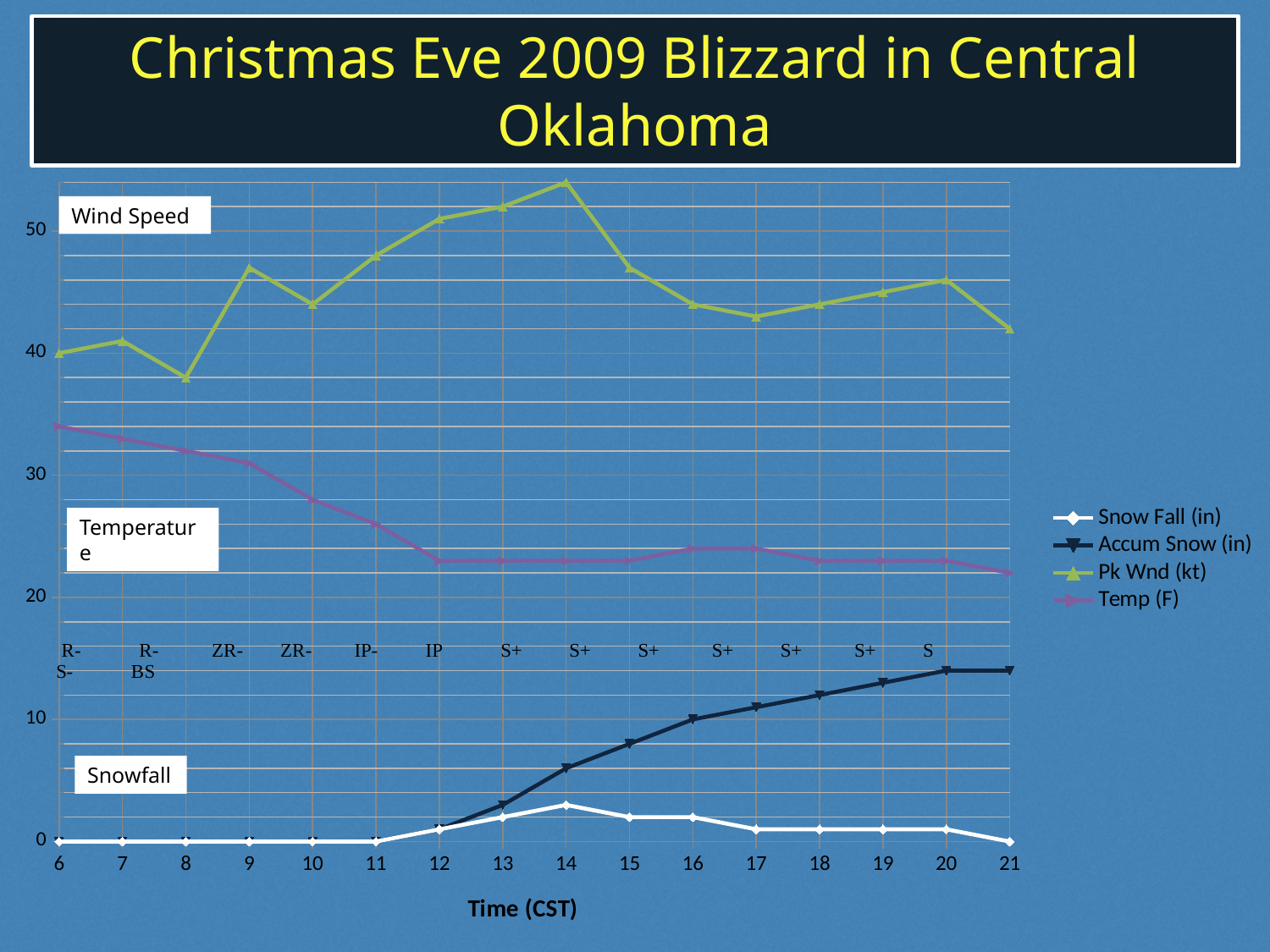
What kind of chart is shown on the slide? line chart What is the title of the x axis? Time (CST) How many time points are shown along the x axis? 16 How many series does the legend list? 4 Which is larger, the Pk Wnd (kt) value at time 9 or at time 10? time 9 At which time (CST) does the Pk Wnd (kt) series reach its highest value? 14 What is the Snow Fall (in) value at time 6? 0 Is the Pk Wnd (kt) value at time 12 greater or less than 50? greater Is the Accum Snow (in) value at time 21 greater or less than 10? greater At which time (CST) does the Pk Wnd (kt) series reach its lowest value? 8 Does the Temp (F) series rise or fall between time 6 and time 12? fall Is the Temp (F) value at time 6 greater or less than 30? greater